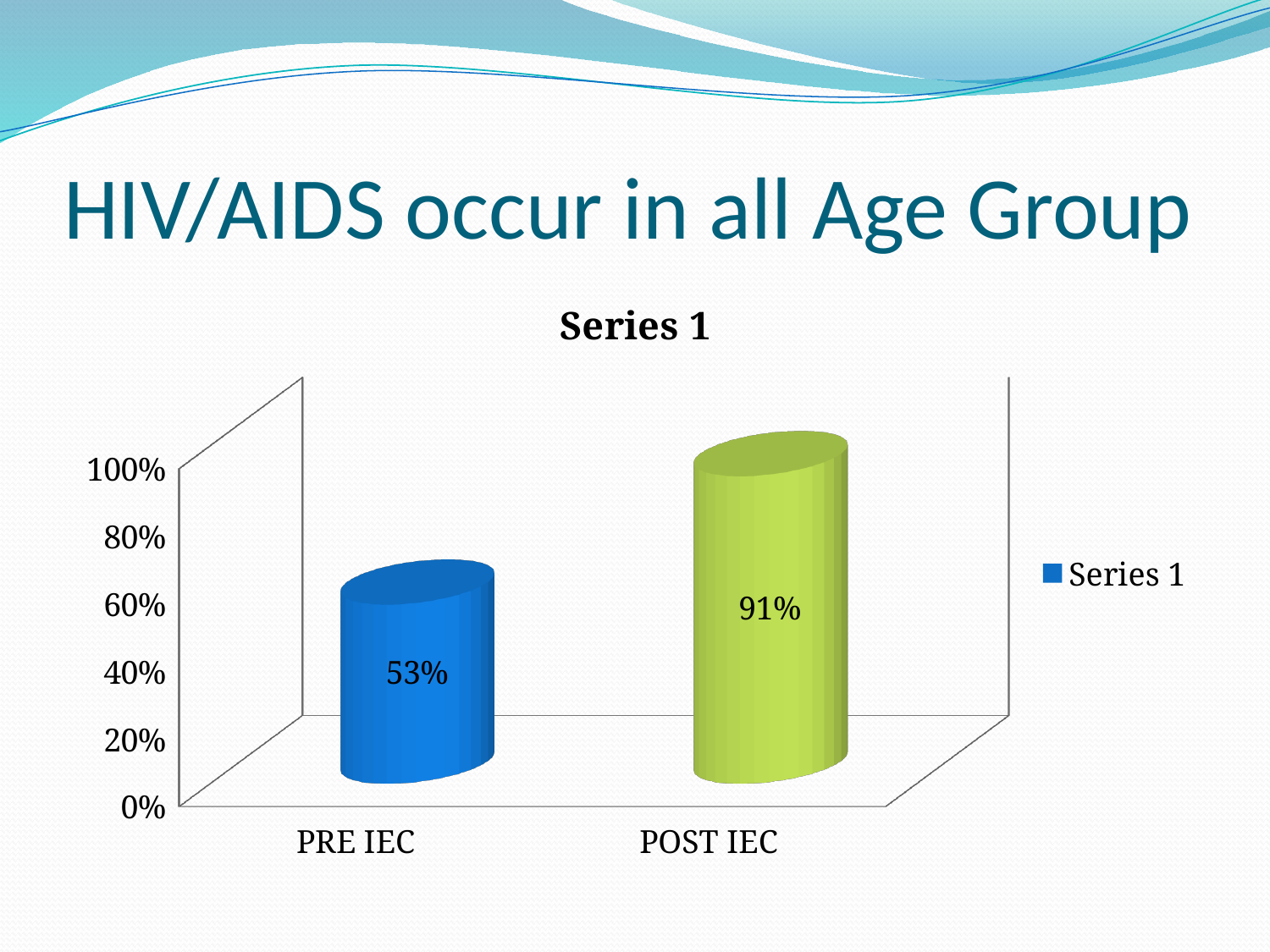
How many categories are shown on the x axis? 2 What is the difference between the POST IEC and PRE IEC values? 38% How many series does the legend list? 1 What is the value for PRE IEC? 53% Is the value for PRE IEC greater or less than 60%? less What is the value for POST IEC? 91% Which category has the lowest value? PRE IEC Which category has the highest value? POST IEC Which is larger, the value for PRE IEC or POST IEC? POST IEC What is the title of the chart? Series 1 Is the value for POST IEC greater or less than 80%? greater What kind of chart is shown? bar chart